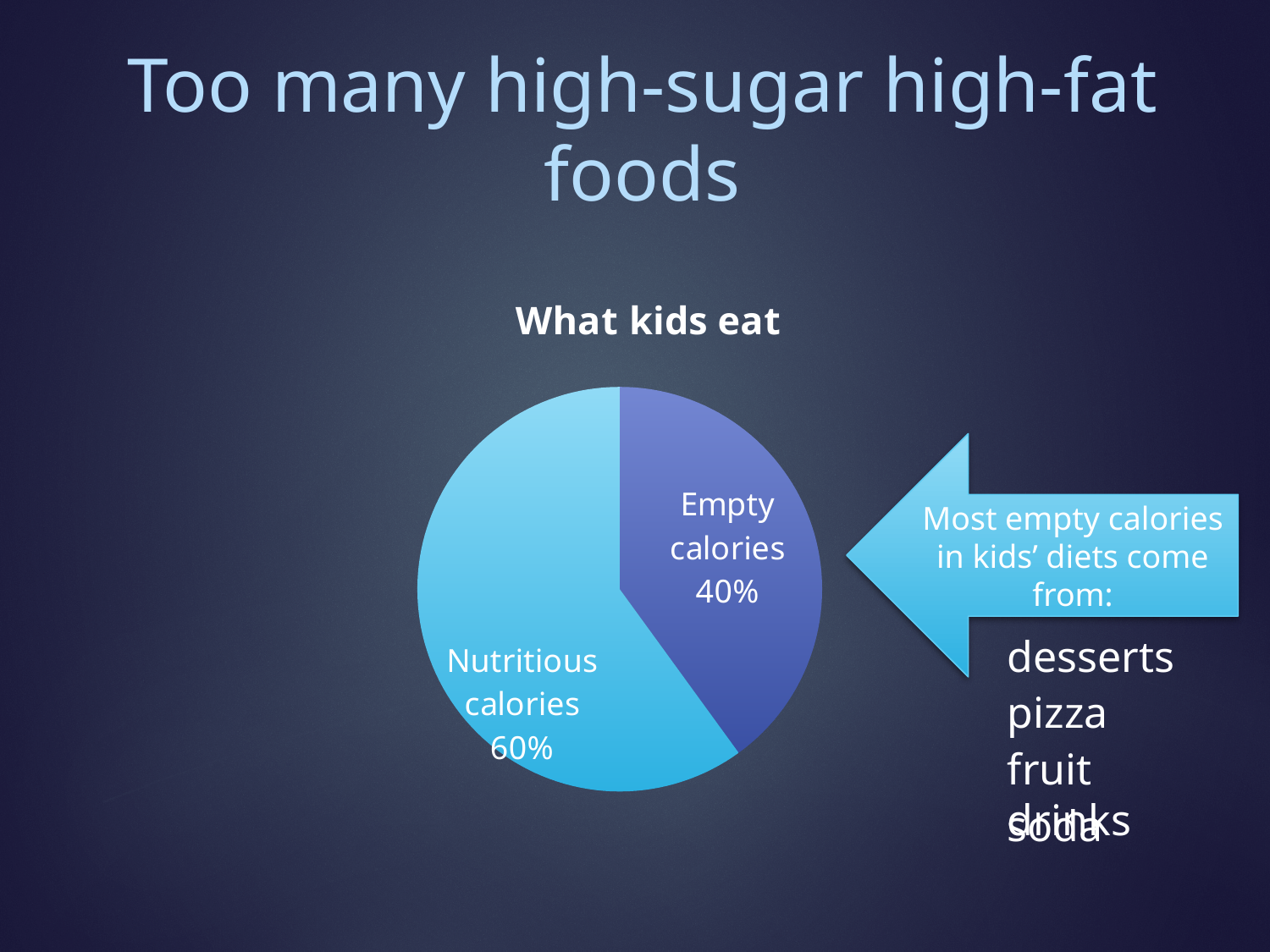
What share of the pie is Nutritious calories? 60% Which is larger, Empty calories or Nutritious calories? Nutritious calories Is the share for Empty calories greater or less than 50%? less Which slice of the pie is the largest? Nutritious calories What is the difference in percentage points between Nutritious calories and Empty calories? 20% What kind of chart is shown on the slide? pie chart What is the total of the two slices shown in the pie chart? 100% Which slice of the pie is the smallest? Empty calories What share of the pie is Empty calories? 40% What is the title of the chart? What kids eat How many slices does the pie chart have? 2